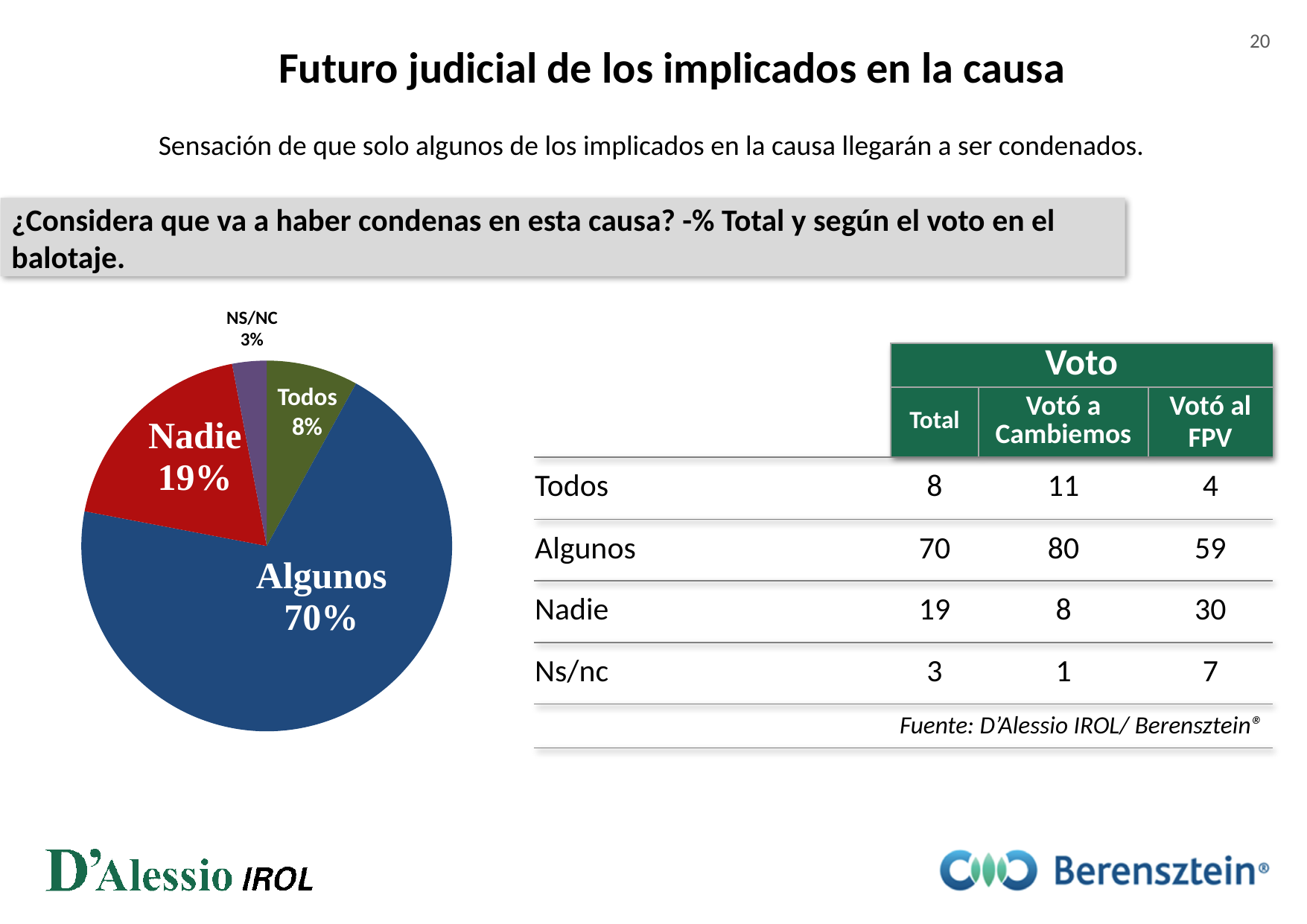
In the pie chart, what share is labelled for "Nadie"? 19% What kind of chart is shown on the slide? Pie chart In the pie chart, what is the difference in percentage points between "Algunos" and "Nadie"? 51 Which slice of the pie chart is the largest? Algunos In the pie chart, what colour is the "Nadie" slice? Red In the pie chart, what colour is the "Algunos" slice? Blue How many slices does the pie chart have? 4 In the pie chart, what share is labelled for "Todos"? 8% In the pie chart, what share is labelled for "NS/NC"? 3% In the pie chart, which is larger: "Nadie" or "Todos"? Nadie In the pie chart, what share is labelled for "Algunos"? 70% Which slice of the pie chart is the smallest? NS/NC